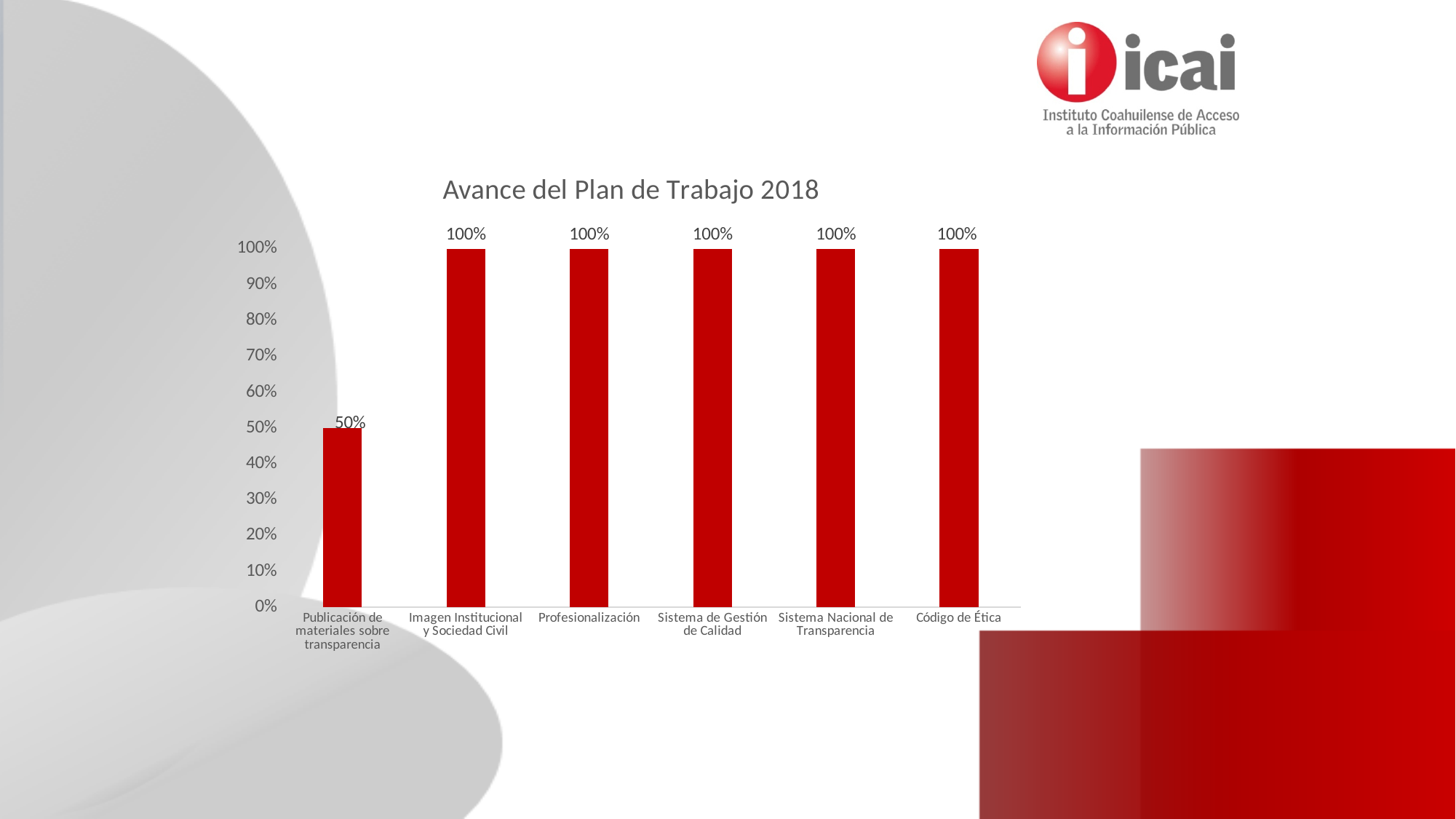
What colour are the bars in the chart? Red Is the value for Publicación de materiales sobre transparencia greater or less than 80%? less What is the value for Código de Ética? 100% What kind of chart is shown on the slide? Bar chart Which is larger, the value for Sistema de Gestión de Calidad or the value for Publicación de materiales sobre transparencia? Sistema de Gestión de Calidad What is the value for Publicación de materiales sobre transparencia? 50% What is the value for Profesionalización? 100% What is the difference between the value for Imagen Institucional y Sociedad Civil and the value for Publicación de materiales sobre transparencia? 50% What is the title of the chart? Avance del Plan de Trabajo 2018 How many categories are plotted in the chart? 6 What is the value for Sistema Nacional de Transparencia? 100% Which category has the lowest value? Publicación de materiales sobre transparencia